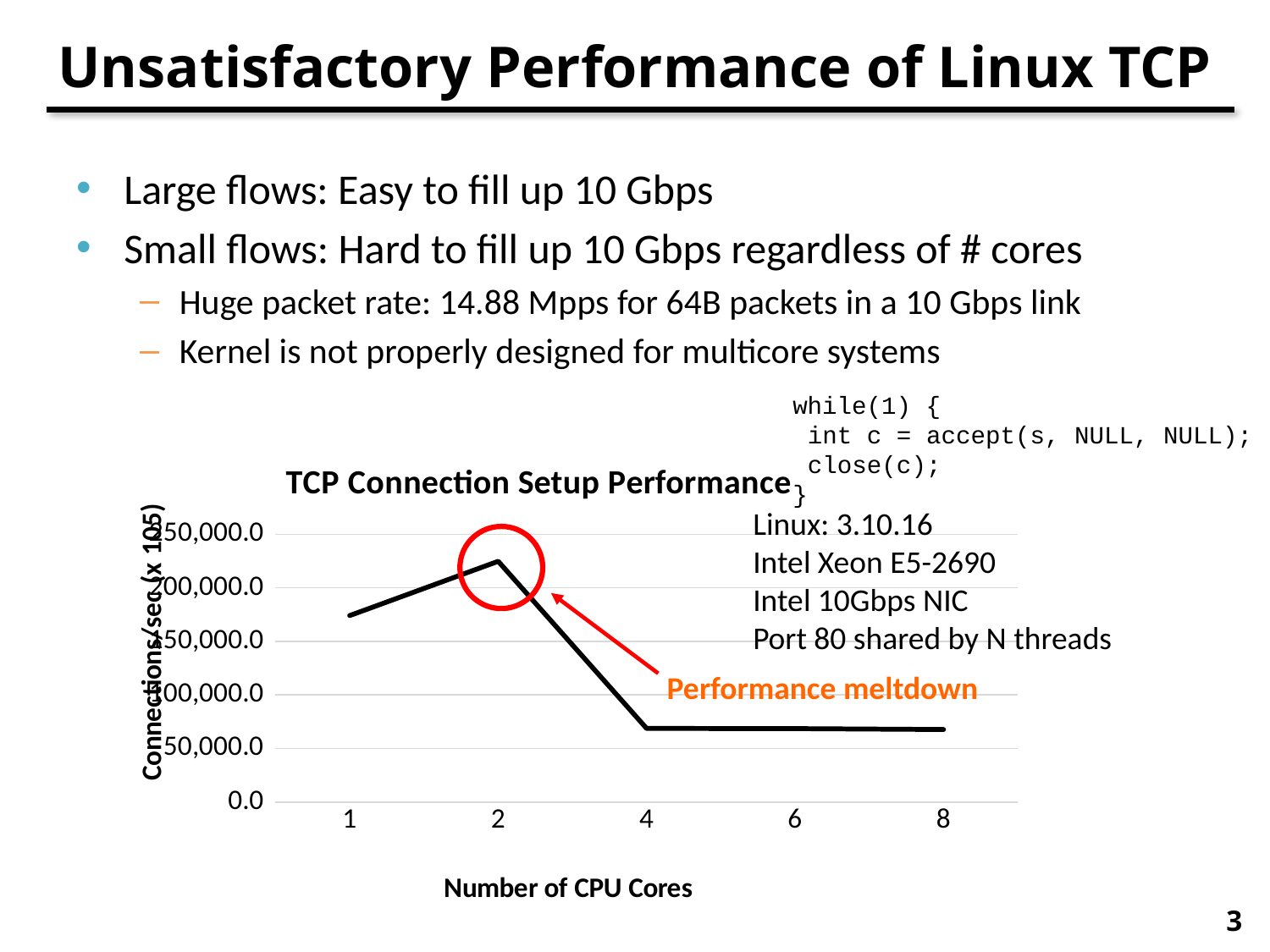
What is the label of the x axis of the chart? Number of CPU Cores At which number of CPU cores is the connection setup performance highest? 2 Is the value for 2 CPU cores greater or less than 200,000.0? greater Which has the higher connections/sec value: 1 CPU core or 8 CPU cores? 1 CPU core Does the connections/sec value rise or fall when going from 2 CPU cores to 4 CPU cores? fall Is the value for 4 CPU cores greater or less than 100,000.0? less How many CPU core counts are plotted on the x axis of the chart? 5 Is the value for 1 CPU core greater or less than 150,000.0? greater What kind of chart is shown on the slide? line chart Which has the higher connections/sec value: 2 CPU cores or 4 CPU cores? 2 CPU cores What is the title of the chart? TCP Connection Setup Performance